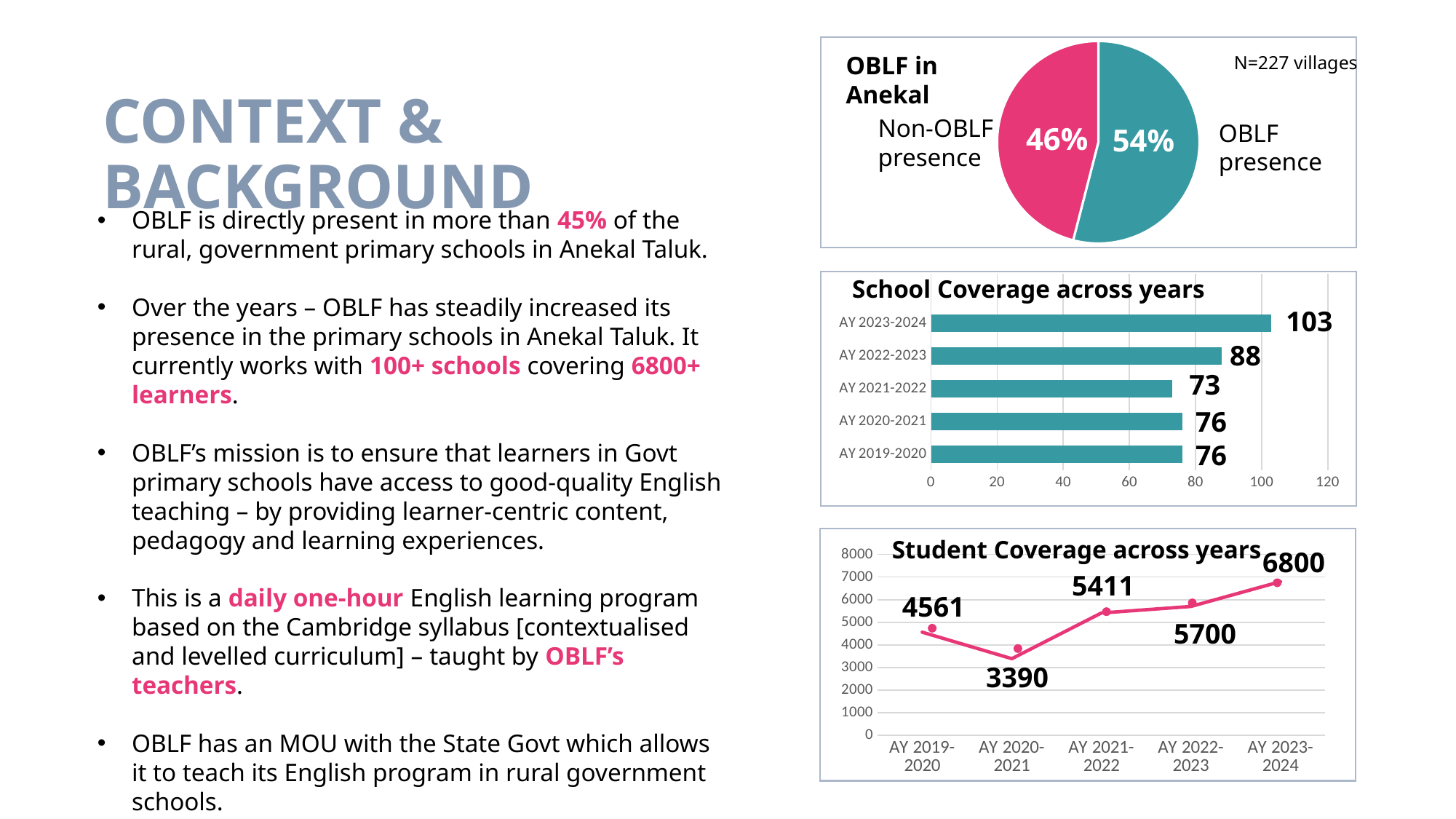
In the 'School Coverage across years' chart, which academic year has the lowest value? AY 2021-2022 What kind of chart is 'Student Coverage across years'? Line chart In the 'Student Coverage across years' chart, what is the difference between AY 2023-2024 and AY 2019-2020? 2239 In the 'OBLF in Anekal' pie chart, what share of villages have OBLF presence? 54% In the 'School Coverage across years' chart, what is the difference between AY 2023-2024 and AY 2022-2023? 15 What kind of chart is 'OBLF in Anekal'? Pie chart How many academic years are shown in the 'School Coverage across years' chart? 5 In the 'Student Coverage across years' chart, which academic year has the highest value? AY 2023-2024 In the 'Student Coverage across years' chart, what is the value for AY 2020-2021? 3390 What kind of chart is 'School Coverage across years'? Bar chart In the 'School Coverage across years' chart, what is the value for AY 2023-2024? 103 In the 'OBLF in Anekal' pie chart, what share of villages have Non-OBLF presence? 46%